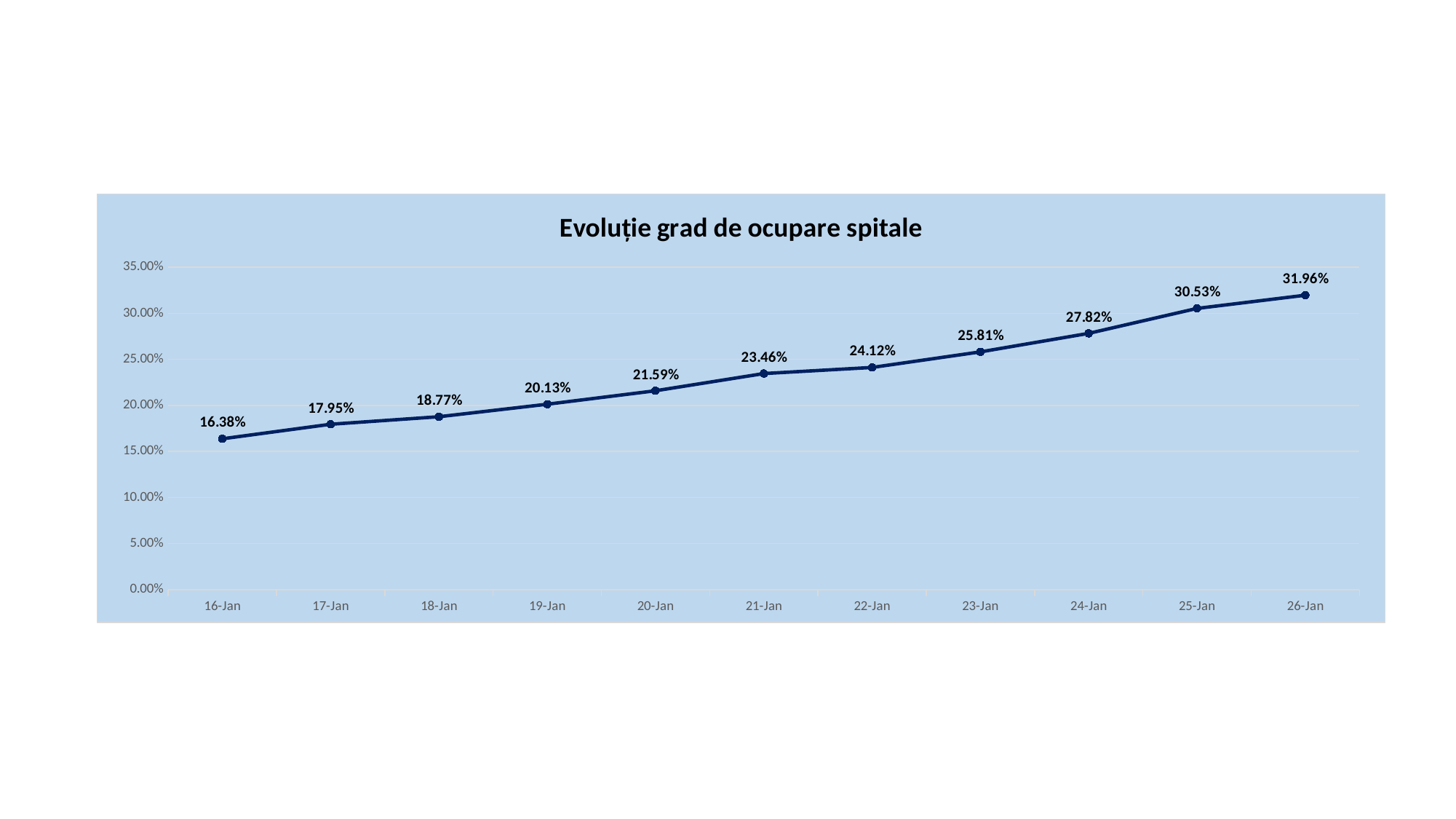
Which is larger, the value for 21-Jan or the value for 19-Jan? 21-Jan What is the difference between the values for 26-Jan and 16-Jan? 15.58% Which date has the lowest value? 16-Jan What is the value for 16-Jan? 16.38% What is the value for 26-Jan? 31.96% How many dates are plotted on the x axis? 11 Is the value for 23-Jan greater or less than 25.00%? greater What is the value for 22-Jan? 24.12% What is the difference between the values for 25-Jan and 24-Jan? 2.71% What kind of chart is shown? line chart Which date has the highest value? 26-Jan Do the values rise or fall from 16-Jan to 26-Jan? rise